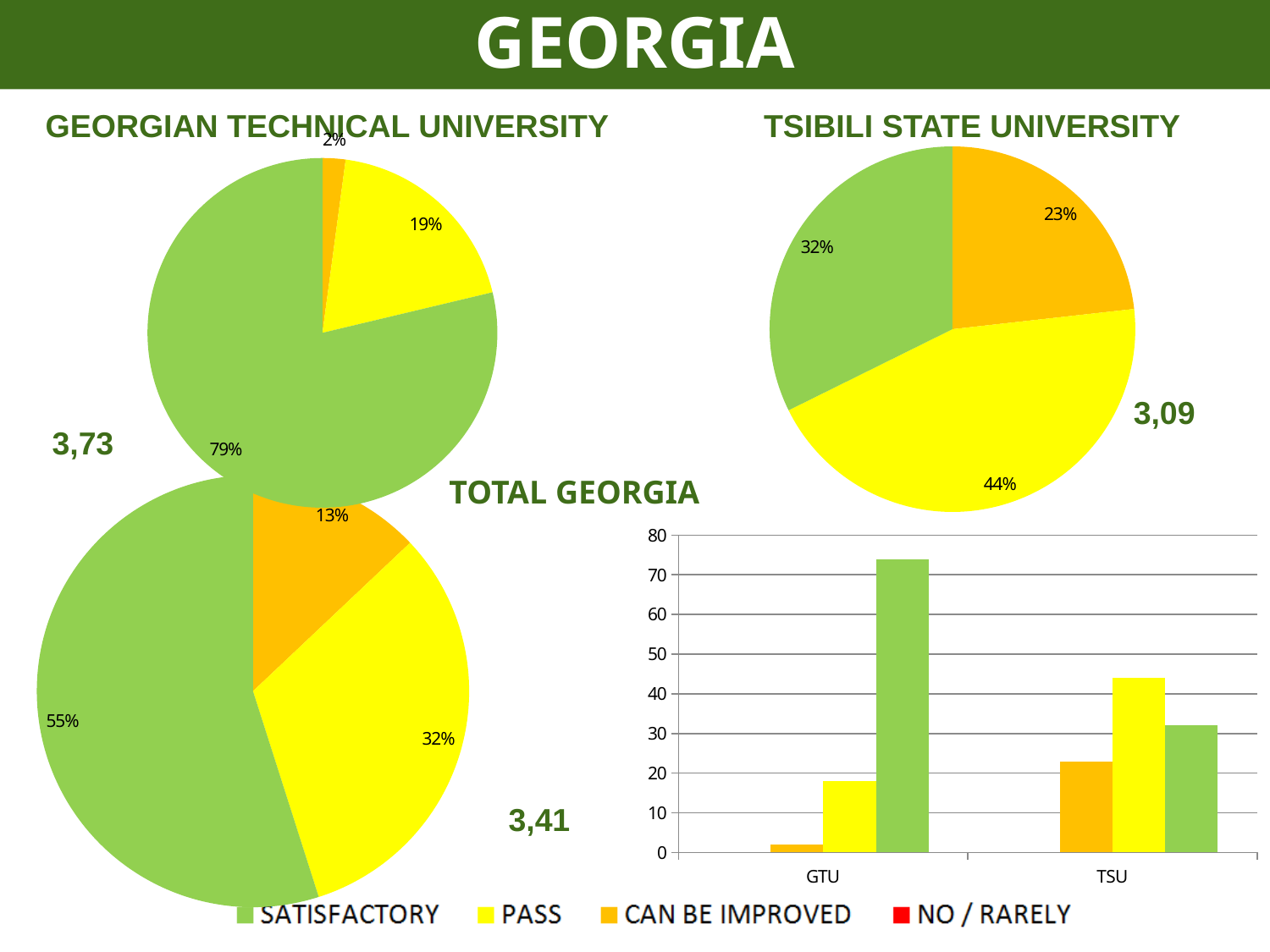
In the bar chart at the bottom right, is the Pass value for TSU greater or less than 40? greater In the bar chart at the bottom right, which university has the larger Satisfactory bar, GTU or TSU? GTU In the Total Georgia pie chart, what is the difference in percentage points between the Satisfactory and Pass slices? 23 In the Tsibili State University pie chart, which category has the smallest slice? Can Be Improved In the Tsibili State University pie chart, what percentage is shown for the Pass slice? 44% In the Georgian Technical University pie chart, which category has the largest slice? Satisfactory In the Georgian Technical University pie chart, what percentage is shown for the Satisfactory slice? 79% In the bar chart at the bottom right, is the Satisfactory value for GTU greater or less than 70? greater What kind of chart is the chart at the bottom right of the slide? bar chart How many entries does the legend at the bottom of the slide list? 4 How many categories are shown on the x axis of the bar chart at the bottom right? 2 In the Total Georgia pie chart, what percentage is shown for the Can Be Improved slice? 13%